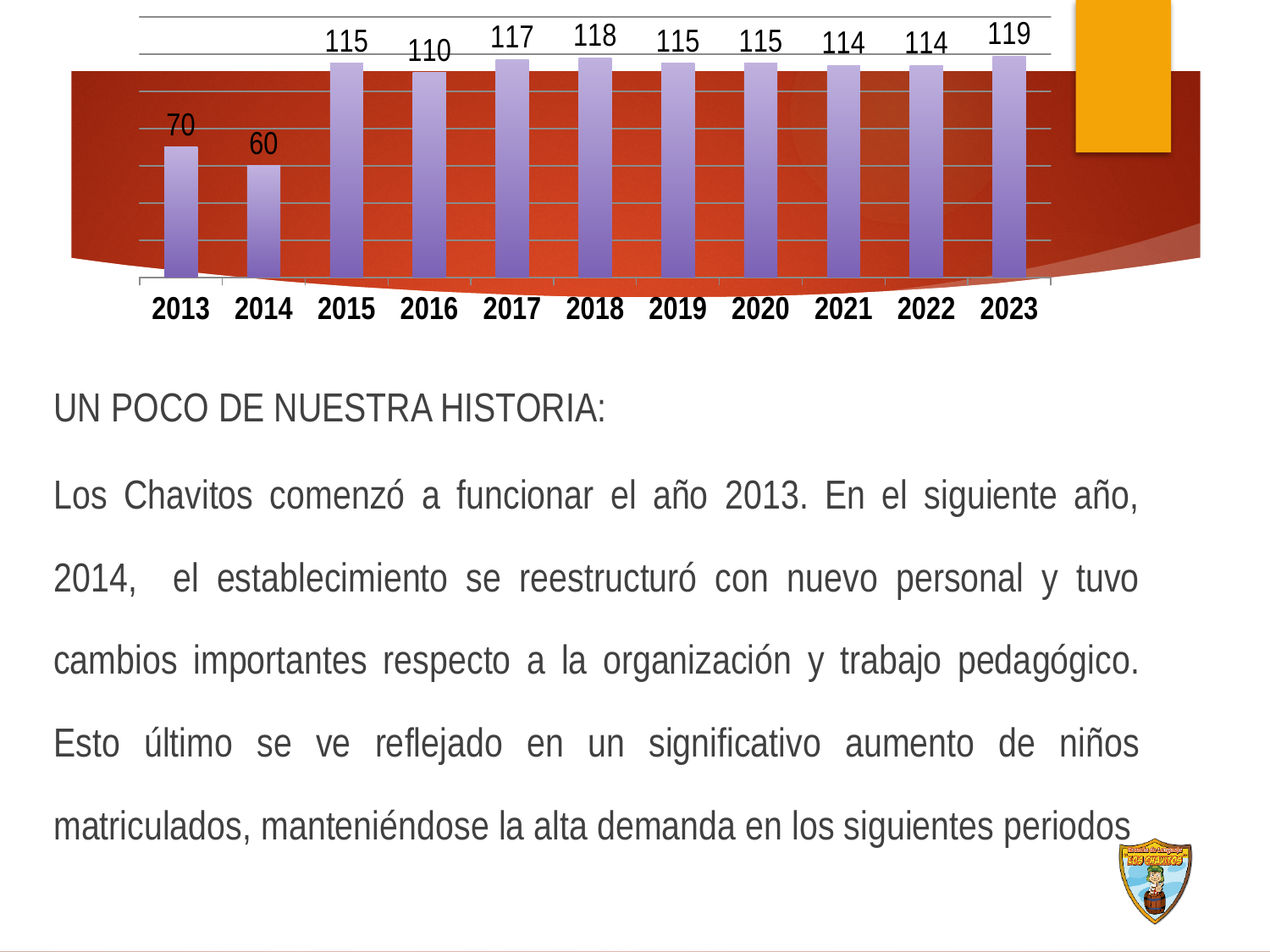
What is the value for 2014? 60 Which year has the highest value? 2023 What kind of chart is this? bar chart What is the difference between the values for 2023 and 2013? 49 What is the value for 2023? 119 What is the value for 2013? 70 What is the difference between the values for 2015 and 2014? 55 What is the value for 2016? 110 Do the values rise or fall from 2014 to 2015? rise Which year has the lowest value? 2014 Which is larger, the value for 2018 or the value for 2016? 2018 How many years are shown on the x axis? 11